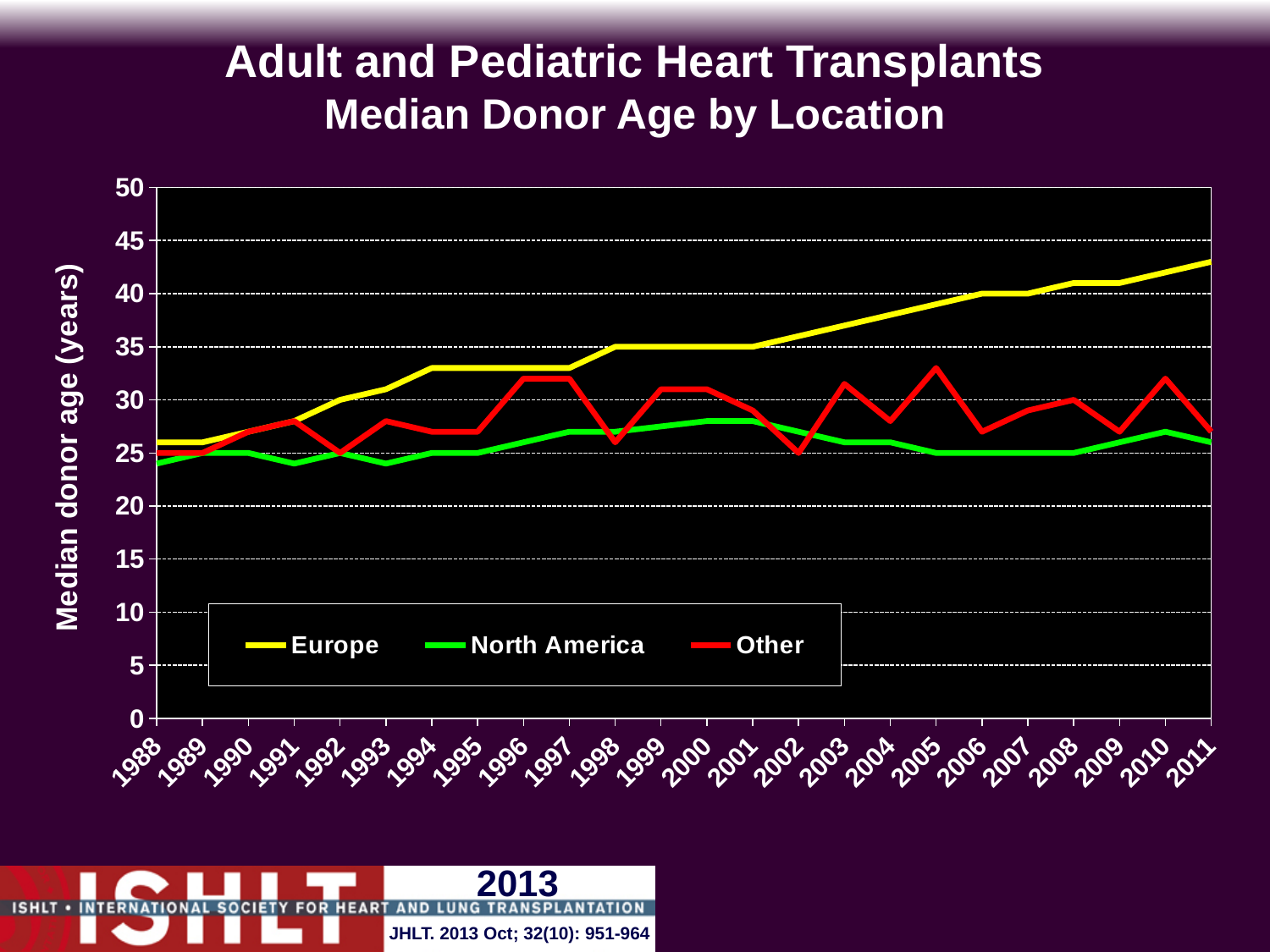
Is the value for North America in 2000 greater or less than 30? less What is the median donor age for Europe in 1998? 35 Does the Europe line generally rise or fall from 1988 to 2011? rise Is the value for Other in 2005 greater or less than 30? greater What is the median donor age for Europe in 2006? 40 What is the label on the y axis? Median donor age (years) Which series has the highest median donor age in 2011? Europe Is the value for Europe in 2011 greater or less than 40? greater In 2011, which is larger: the value for Europe or the value for North America? Europe What kind of chart is shown on the slide? line chart How many years are shown along the x axis? 24 How many series does the legend list? 3